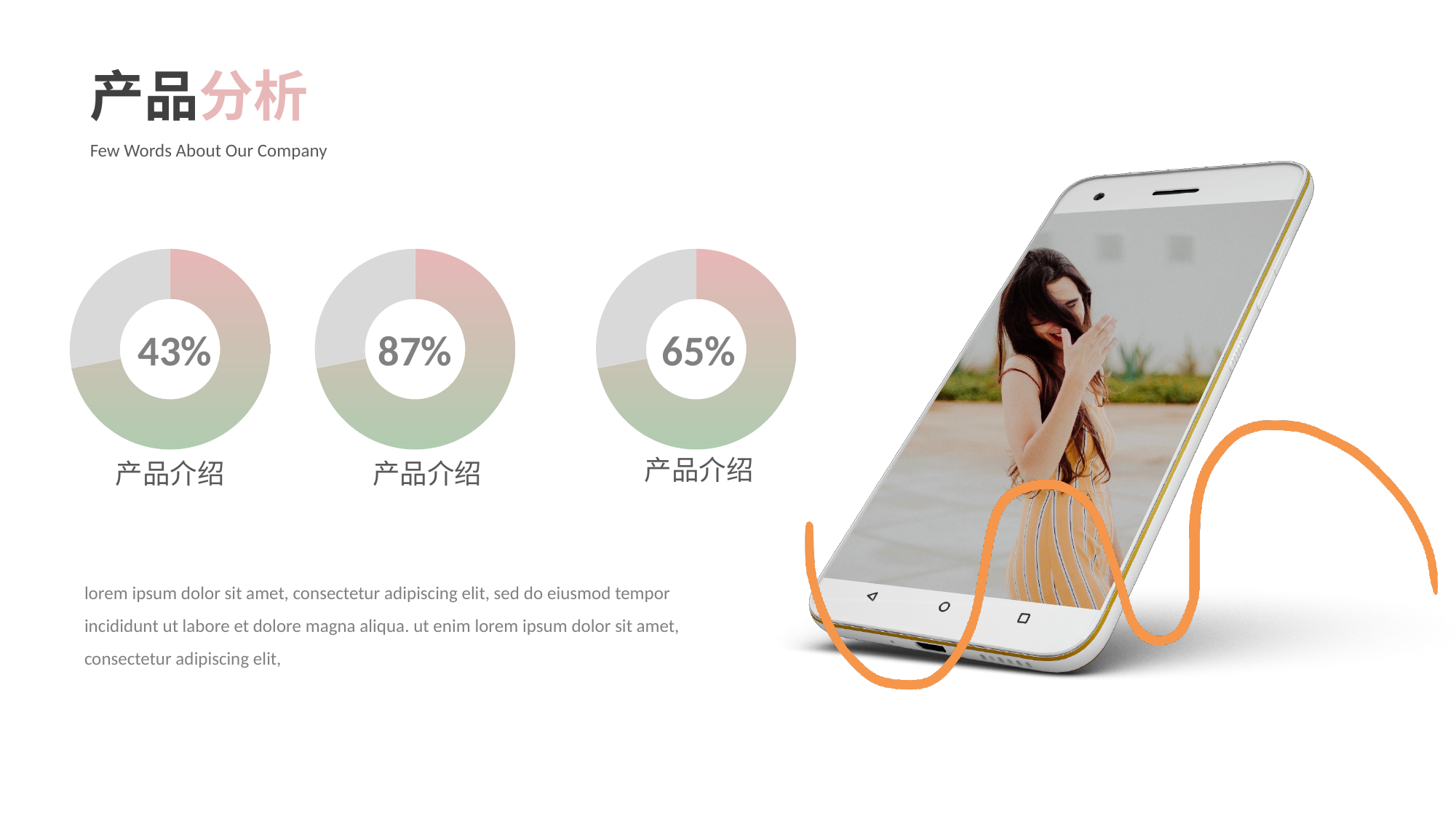
What is the difference between the percentage in the middle donut chart and the percentage in the right donut chart? 22% How many donut charts are on the slide? 3 What is the difference between the percentage in the middle donut chart and the percentage in the left donut chart? 44% Which donut chart shows the highest percentage: left, middle or right? middle What is the label printed below the left donut chart? 产品介绍 What is the title of the slide containing the three donut charts? 产品分析 What kind of chart is used to display the three percentages on the slide? donut chart What percentage is shown in the centre of the right donut chart? 65% Which donut chart shows the lowest percentage: left, middle or right? left Which is larger, the percentage in the right donut chart or the percentage in the left donut chart? right donut chart What percentage is shown in the centre of the left donut chart? 43% What percentage is shown in the centre of the middle donut chart? 87%